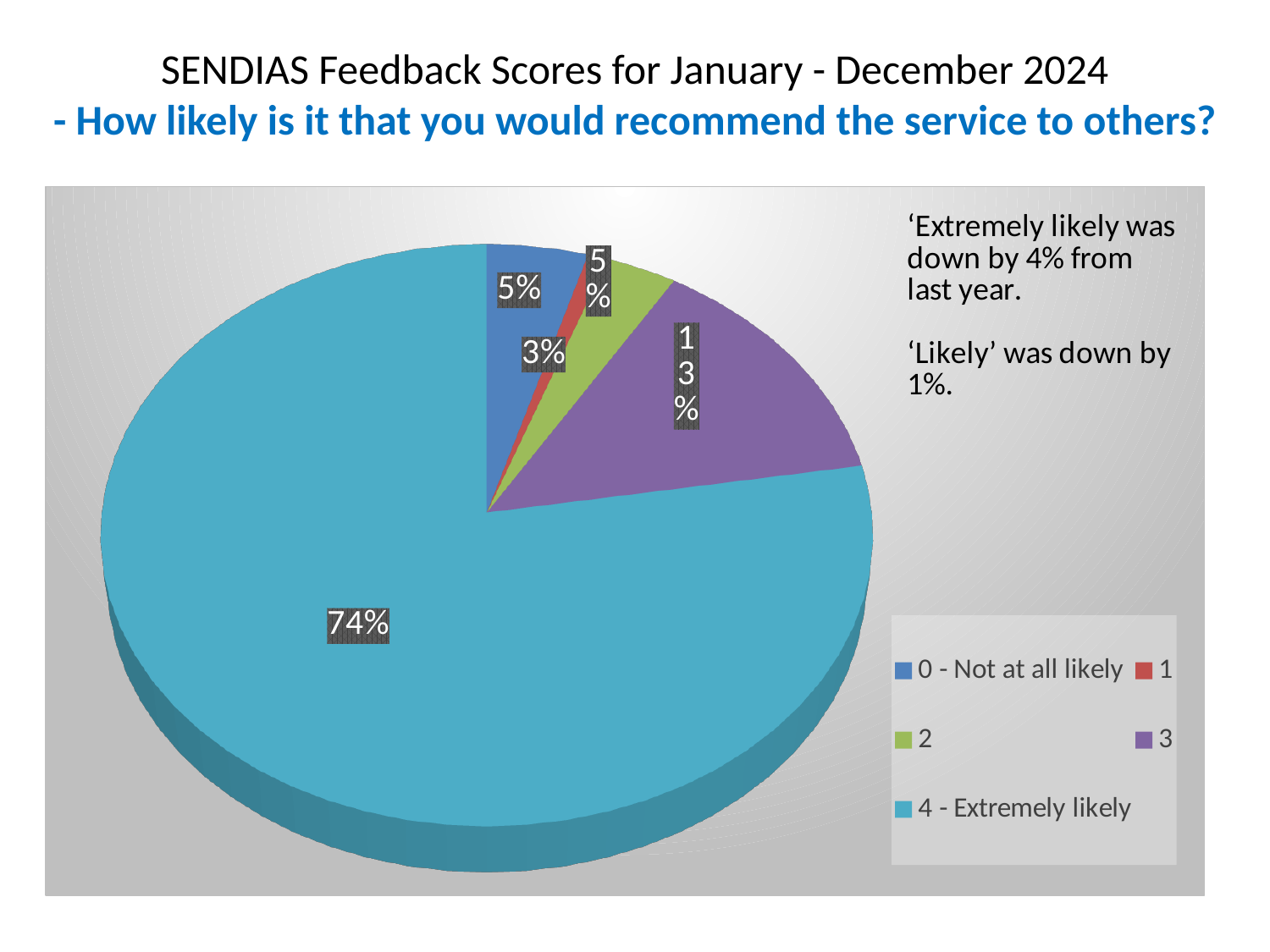
Is the share for '4 - Extremely likely' greater or less than 50%? greater What is the difference in percentage points between '3' and '0 - Not at all likely'? 8 What colour is the '4 - Extremely likely' slice? light blue Which response category has the largest share of the pie? 4 - Extremely likely How many response categories does the legend list? 5 What percentage of respondents answered '4 - Extremely likely'? 74% Which is larger, the share for '3' or the share for '0 - Not at all likely'? 3 According to the text on the slide, by how much was 'Extremely likely' down from last year? 4% What percentage of respondents answered '3'? 13% What percentage of respondents answered '0 - Not at all likely'? 5% What is the difference in percentage points between '4 - Extremely likely' and '3'? 61 What kind of chart is shown on the slide? pie chart